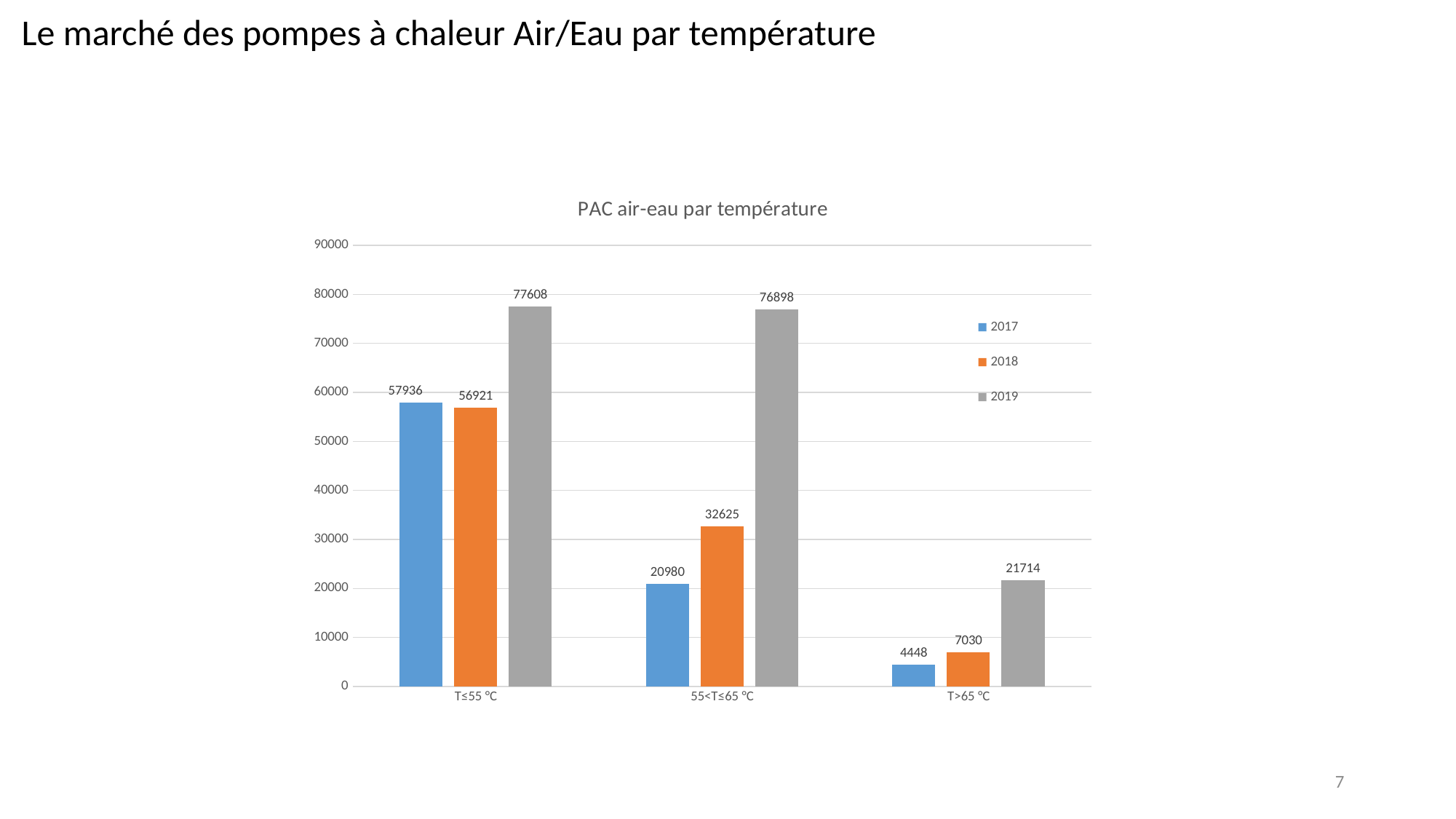
Which category has the lowest value for 2017? T>65 °C Which category has the highest value for 2019? T≤55 °C How many series does the legend list? 3 What is the value for 2018 in the T>65 °C category? 7030 Is the value for 2019 in the T>65 °C category greater or less than 20000? greater What kind of chart is shown on the slide? bar chart How many temperature categories are shown on the x axis? 3 What is the title of the chart? PAC air-eau par température What is the difference between the 2018 and 2017 values in the 55<T≤65 °C category? 11645 What is the value for 2019 in the T≤55 °C category? 77608 Which is larger in the T≤55 °C category: the 2017 value or the 2018 value? 2017 What is the value for 2017 in the 55<T≤65 °C category? 20980